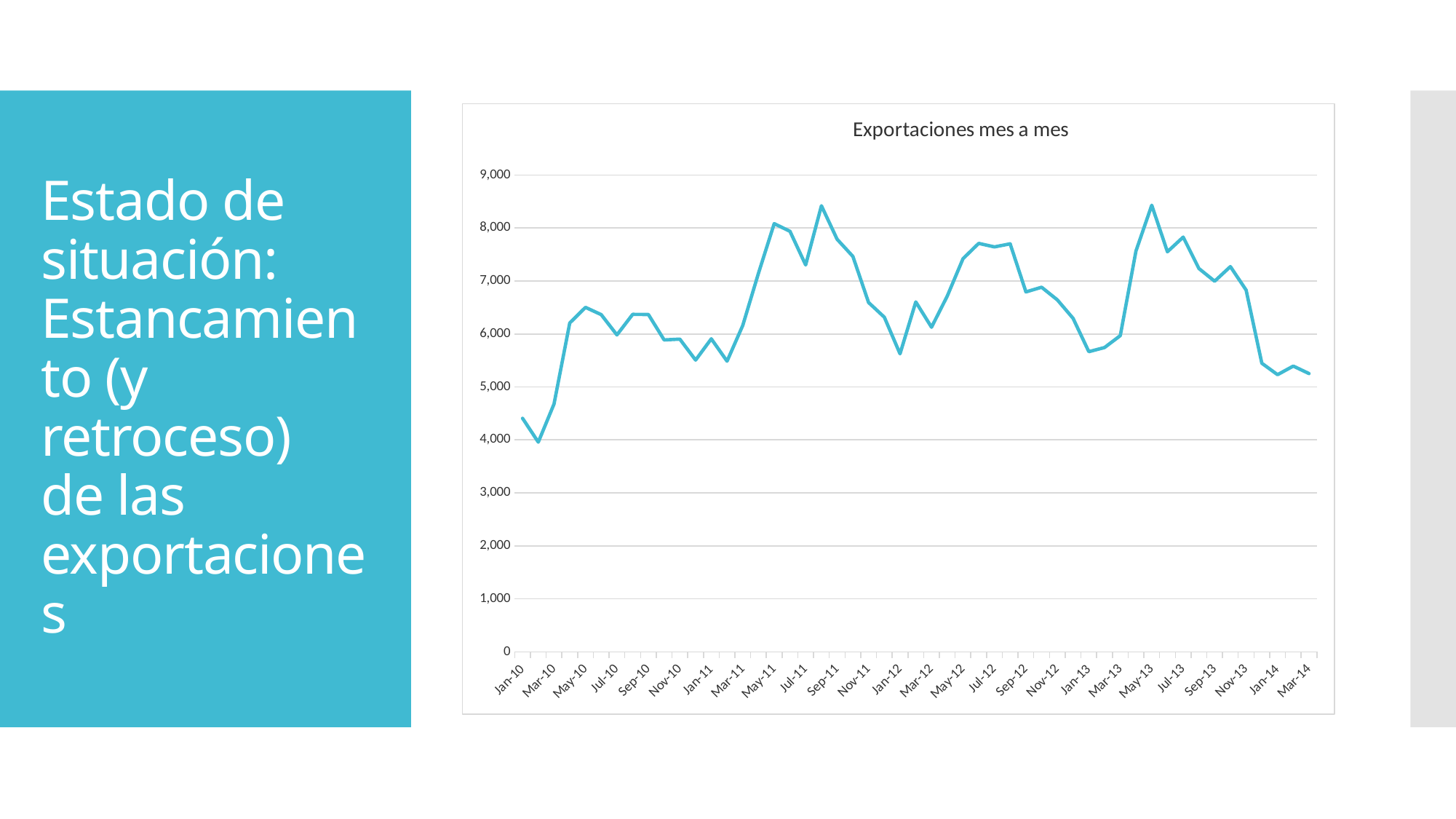
Do the values rise or fall from Nov-13 to Mar-14? fall Is the value for Mar-14 greater or less than 6,000? less Is the value for Sep-11 greater or less than 7,000? greater Is the value for Jan-12 greater or less than 6,000? less What is the highest value shown on the vertical axis of the chart? 9,000 What is the title of the chart? Exportaciones mes a mes Which is larger, the value for Jan-10 or the value for Mar-14? Mar-14 Which is larger, the value for May-10 or the value for May-11? May-11 How many month labels are shown along the x axis of the chart? 26 What kind of chart is shown on the slide? line chart